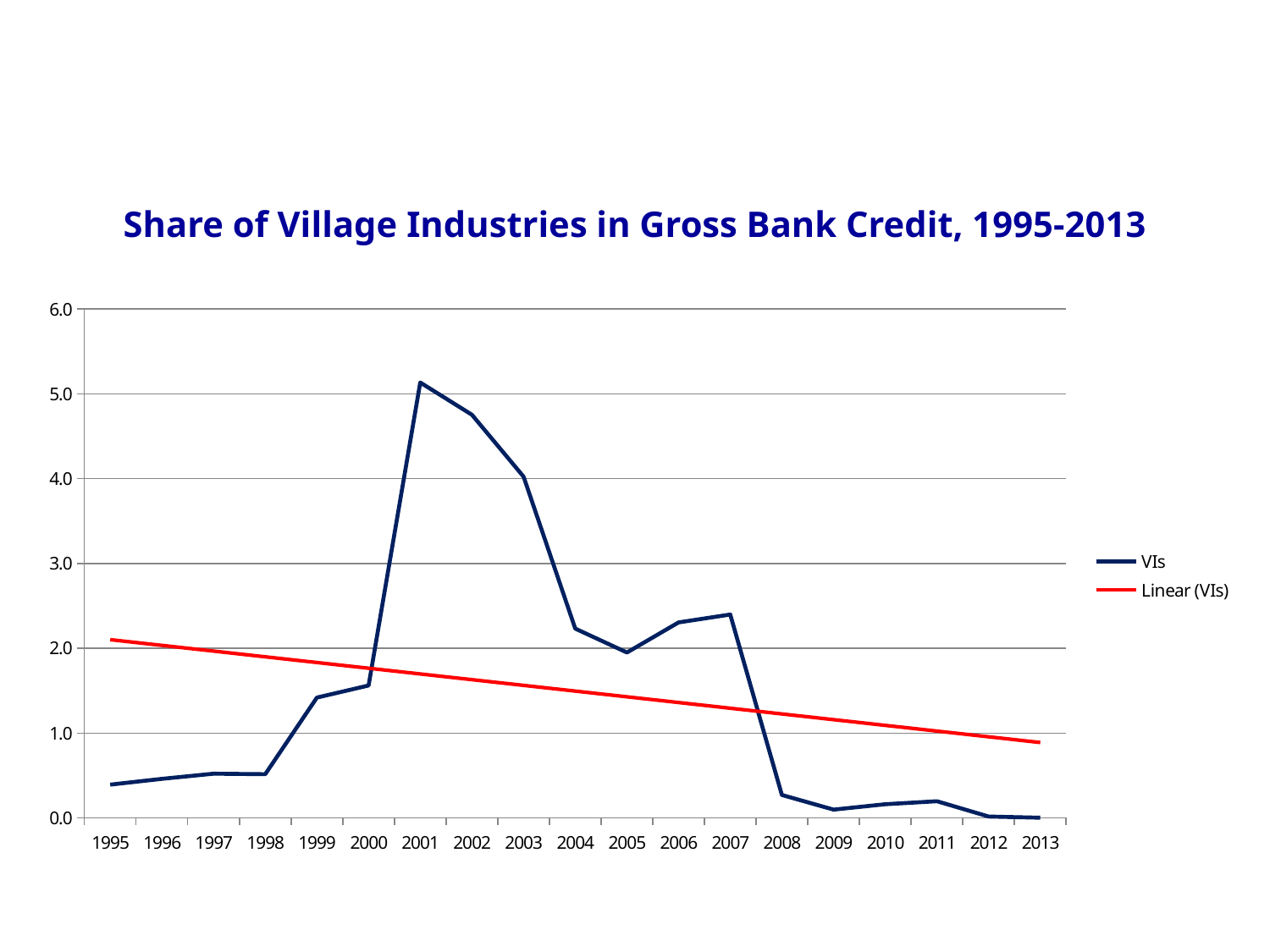
Is the VIs value for 2001 greater or less than 5.0? greater In which year does the VIs series reach its highest value? 2001 What kind of chart is shown on the slide? Line chart What is the title of the chart? Share of Village Industries in Gross Bank Credit, 1995-2013 Which year has the larger VIs value, 2001 or 2007? 2001 How many years are shown on the x axis? 19 Is the VIs value for 2008 greater or less than 1.0? less Is the VIs value for 2002 greater or less than 4.0? greater What are the two entries in the legend? VIs and Linear (VIs) How many series does the legend list? 2 Does the Linear (VIs) trend line rise or fall from 1995 to 2013? Fall